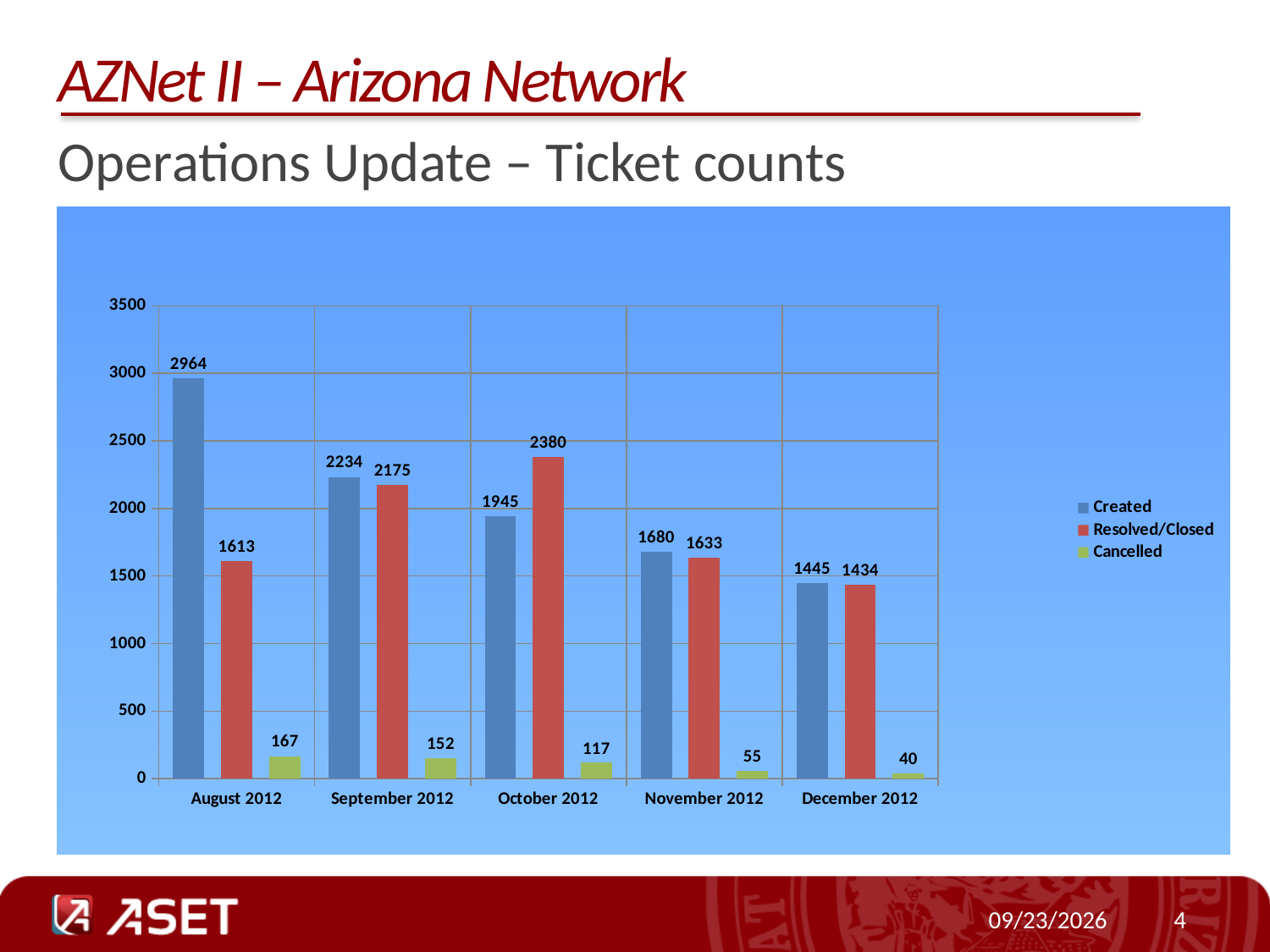
What is the Resolved/Closed value for October 2012? 2380 How many series does the legend list? 3 Which month has the lowest Cancelled value? December 2012 How many tickets were Cancelled in December 2012? 40 Does the Cancelled series rise or fall from August 2012 to December 2012? fall What kind of chart is shown on the slide? bar chart In October 2012, which is larger: Created or Resolved/Closed? Resolved/Closed How many tickets were Created in August 2012? 2964 How many months are shown on the x axis? 5 Which month has the highest Created value? August 2012 What is the difference between Created and Resolved/Closed tickets in August 2012? 1351 Is the Created value for November 2012 greater or less than 1500? greater